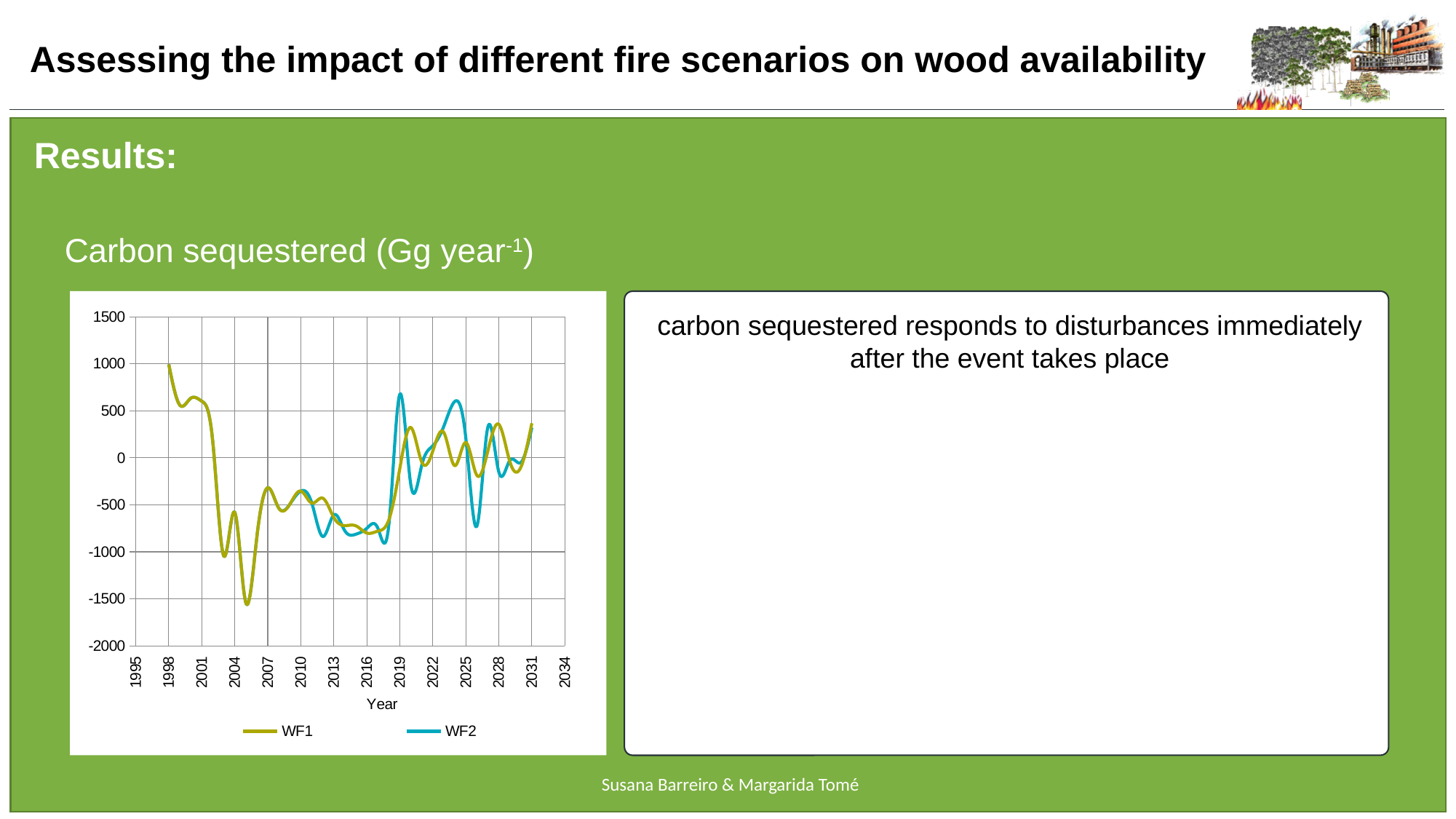
Does the WF1 series rise or fall between 1998 and 2005? fall What are the names of the two series in the chart legend? WF1 and WF2 What is the lowest value shown on the y axis of the chart? -2000 At 2019, which series has the higher value, WF1 or WF2? WF2 Is the value of WF1 at 1998 greater or less than 500? greater How many series does the legend of the chart list? 2 What is the label of the x axis of the chart? Year Is the peak value of WF2 around 2019 greater or less than 500? greater What kind of chart is shown on the slide? line chart Is the value of WF1 at 2016 greater or less than -500? less